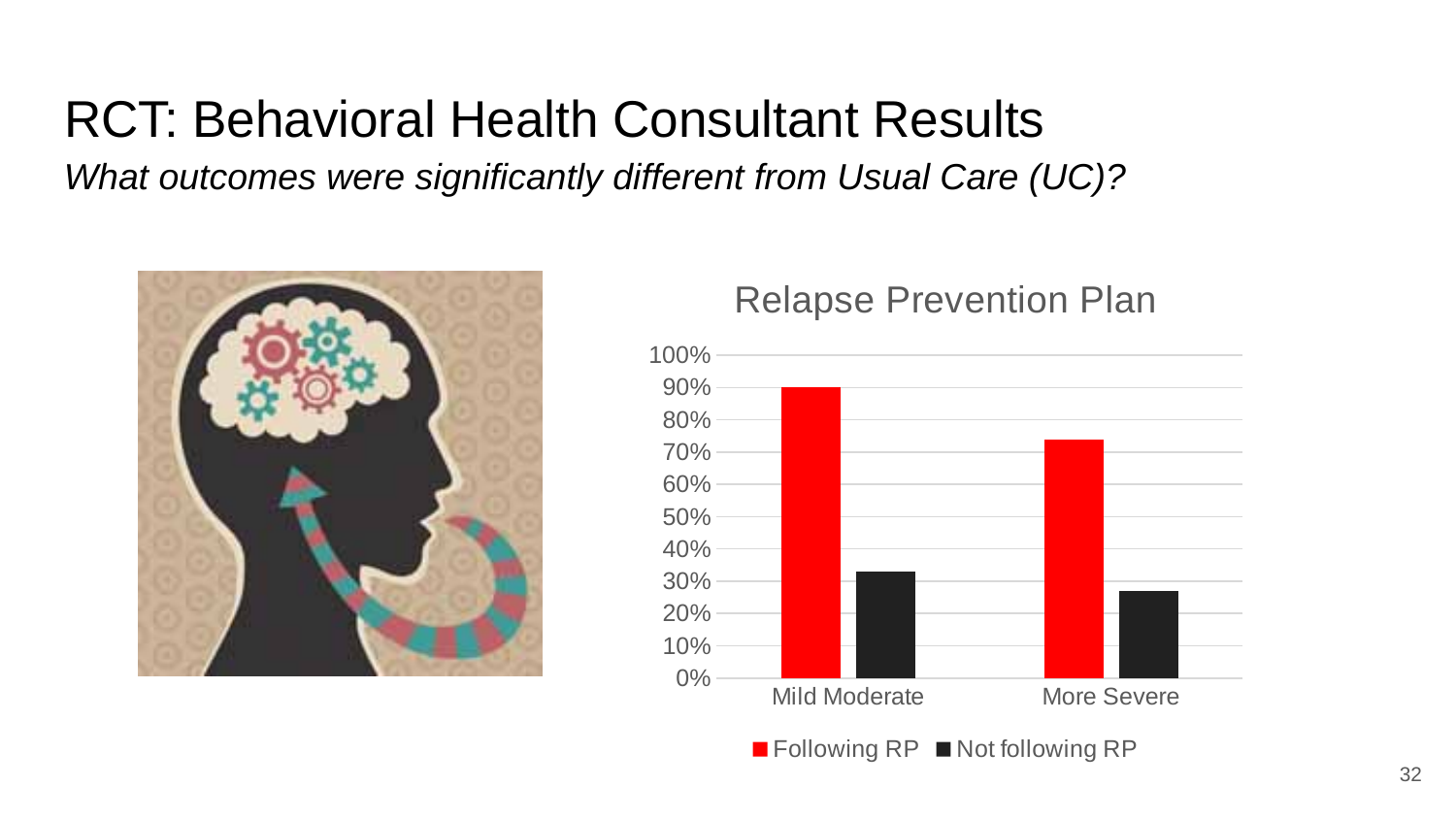
What is the title of the chart? Relapse Prevention Plan Which bar is the lowest in the chart? Not following RP for More Severe How many series does the chart's legend list? 2 How many categories are shown on the x axis of the chart? 2 Does the Following RP value rise or fall from Mild Moderate to More Severe? fall Is the Following RP value for More Severe greater or less than 70%? greater What colour are the bars for the Following RP series? Red Which category has the higher Following RP value? Mild Moderate Is the Not following RP value for Mild Moderate greater or less than 40%? less In the More Severe category, which is larger: Following RP or Not following RP? Following RP Is the Not following RP value for More Severe greater or less than 30%? less What kind of chart is shown on the slide? Bar chart